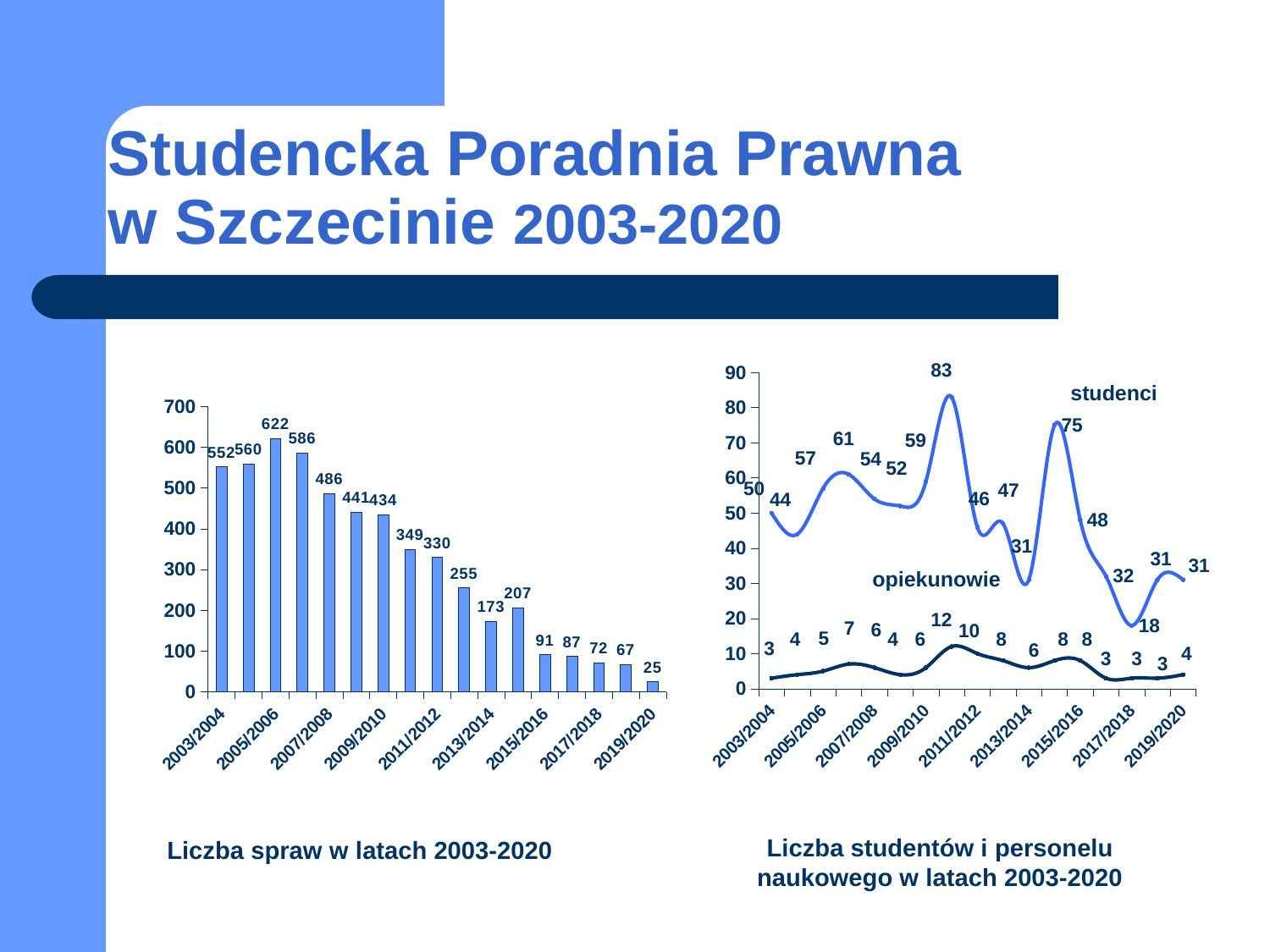
In the chart 'Liczba spraw w latach 2003-2020', do the values generally rise or fall from 2005/2006 to 2019/2020? fall In the chart 'Liczba spraw w latach 2003-2020', what is the value for 2019/2020? 25 In the chart 'Liczba studentów i personelu naukowego w latach 2003-2020', which series has the larger value in 2013/2014, studenci or opiekunowie? studenci How many series are plotted in the chart 'Liczba studentów i personelu naukowego w latach 2003-2020'? 2 In the chart 'Liczba spraw w latach 2003-2020', what is the difference between the values for 2007/2008 and 2009/2010? 52 In the chart 'Liczba studentów i personelu naukowego w latach 2003-2020', what is the value for studenci in 2011/2012? 46 In the chart 'Liczba spraw w latach 2003-2020', which year has the lowest value? 2019/2020 In the chart 'Liczba studentów i personelu naukowego w latach 2003-2020', what is the highest value for studenci? 83 In the chart 'Liczba spraw w latach 2003-2020', what is the highest value shown? 622 In the chart 'Liczba spraw w latach 2003-2020', what is the value for 2003/2004? 552 What kind of chart is 'Liczba spraw w latach 2003-2020'? bar chart In the chart 'Liczba studentów i personelu naukowego w latach 2003-2020', what is the value for opiekunowie in 2003/2004? 3